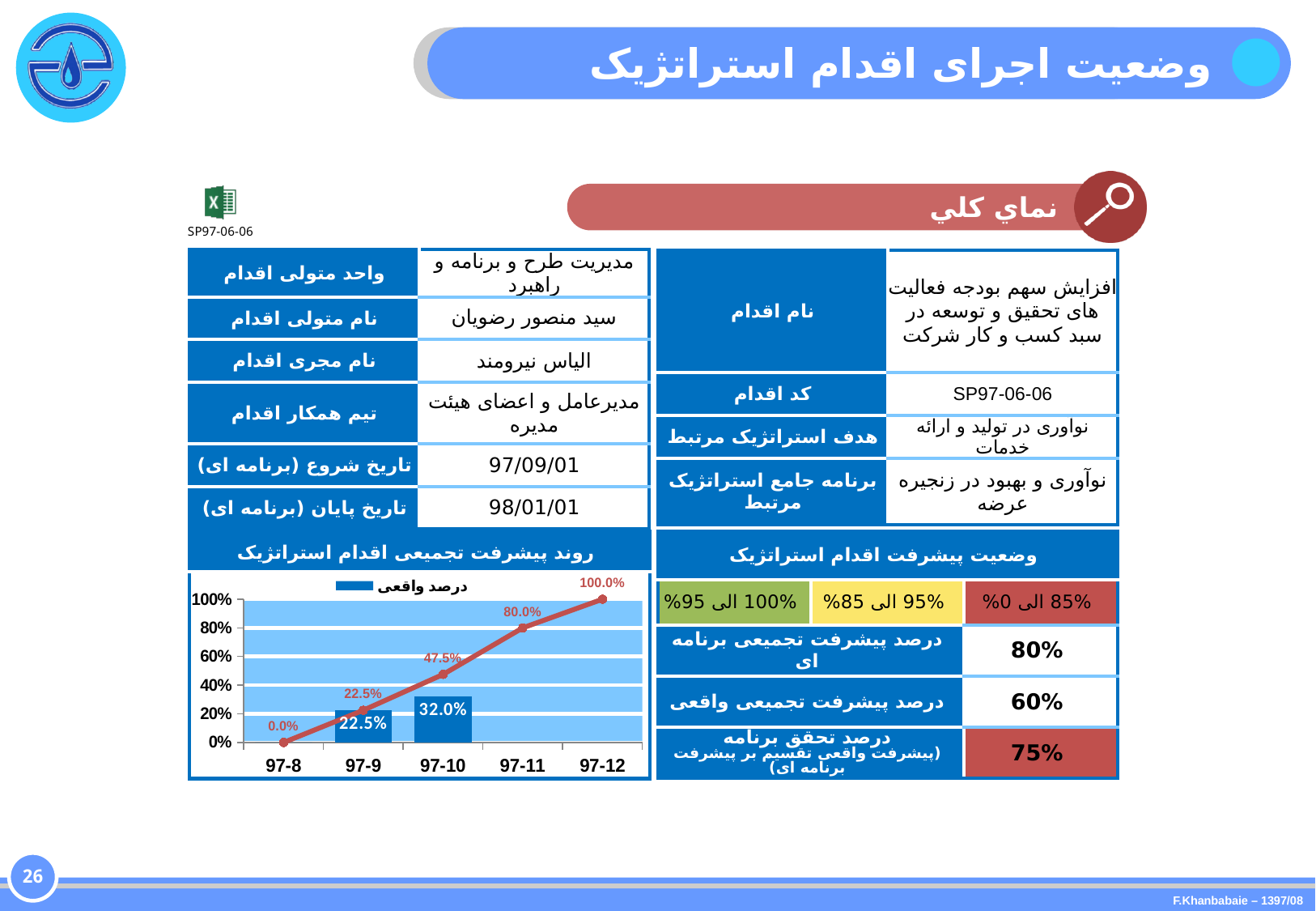
In the chart, which blue bar is taller, 97-9 or 97-10? 97-10 How many categories are shown on the x axis of the chart? 5 In the chart, what is the difference between the red line values at 97-11 and 97-10? 32.5% In the chart, does the red line rise or fall from 97-8 to 97-12? Rise In the chart, at which category does the red line have its lowest value? 97-8 In the chart titled 'روند پیشرفت تجمیعی اقدام استراتژیک', what is the value of the red line at 97-11? 80.0% In the chart, what is the value of the red line at 97-9? 22.5% In the chart, what is the value of the red line at 97-12? 100.0% In the chart, what is the difference between the blue bar values at 97-10 and 97-9? 9.5% What kind of chart is shown on the slide? Bar chart combined with a line In the chart, what is the value of the blue bar at 97-10? 32.0% In the chart, at which category does the red line reach its highest value? 97-12